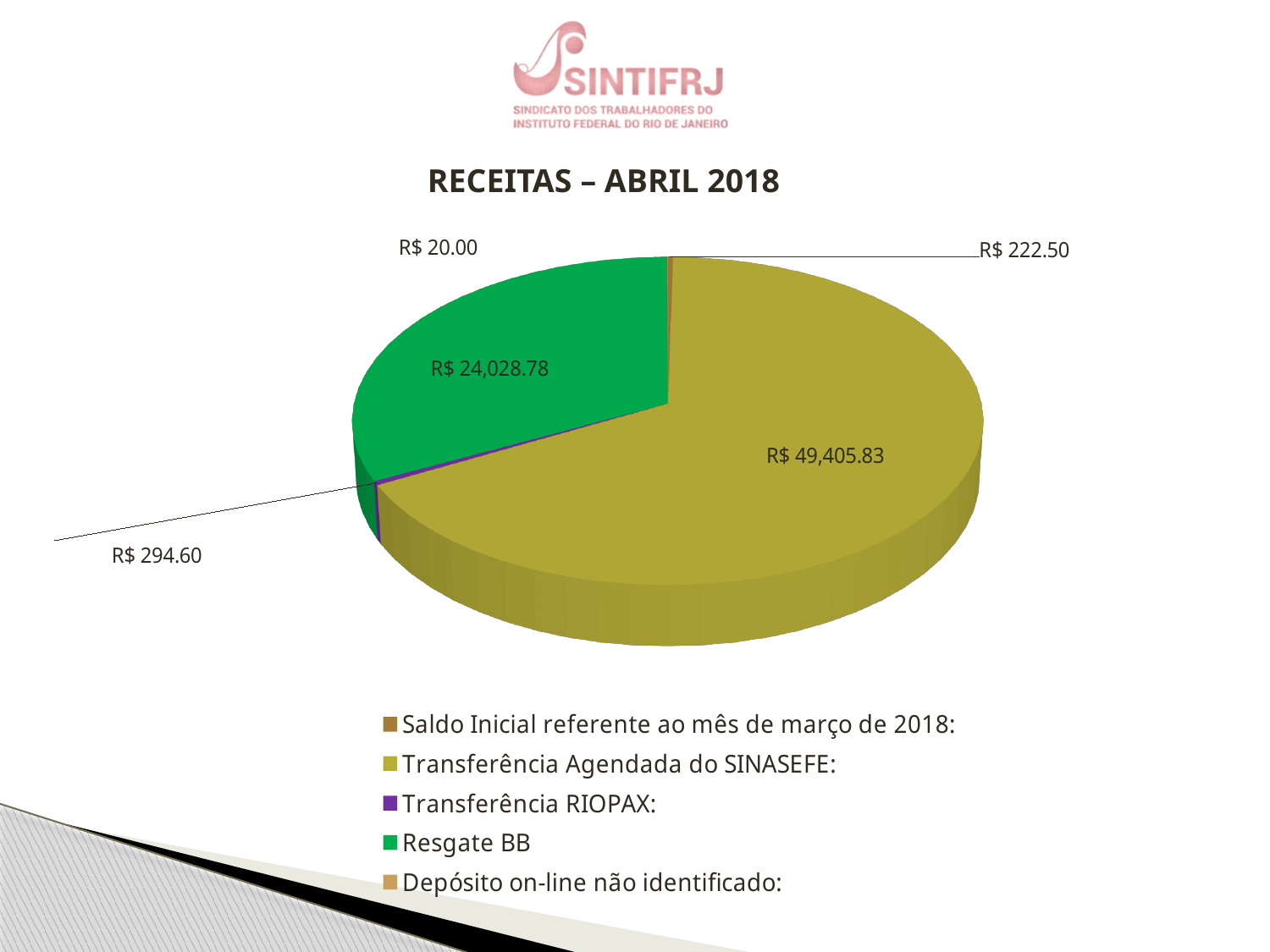
What is the value for Transferência RIOPAX? R$ 294.60 Which category has the largest slice of the pie? Transferência Agendada do SINASEFE What is the value for Depósito on-line não identificado? R$ 20.00 What is the value for Transferência Agendada do SINASEFE? R$ 49,405.83 What is the difference between the value for Transferência Agendada do SINASEFE and the value for Resgate BB? R$ 25,377.05 Which is larger, the value for Transferência RIOPAX or the value for Saldo Inicial referente ao mês de março de 2018? Transferência RIOPAX What is the value for Saldo Inicial referente ao mês de março de 2018? R$ 222.50 What kind of chart is shown on the slide? Pie chart What is the value for Resgate BB? R$ 24,028.78 What is the title of the chart? RECEITAS – ABRIL 2018 Which category has the smallest slice of the pie? Depósito on-line não identificado How many entries does the chart legend list? 5